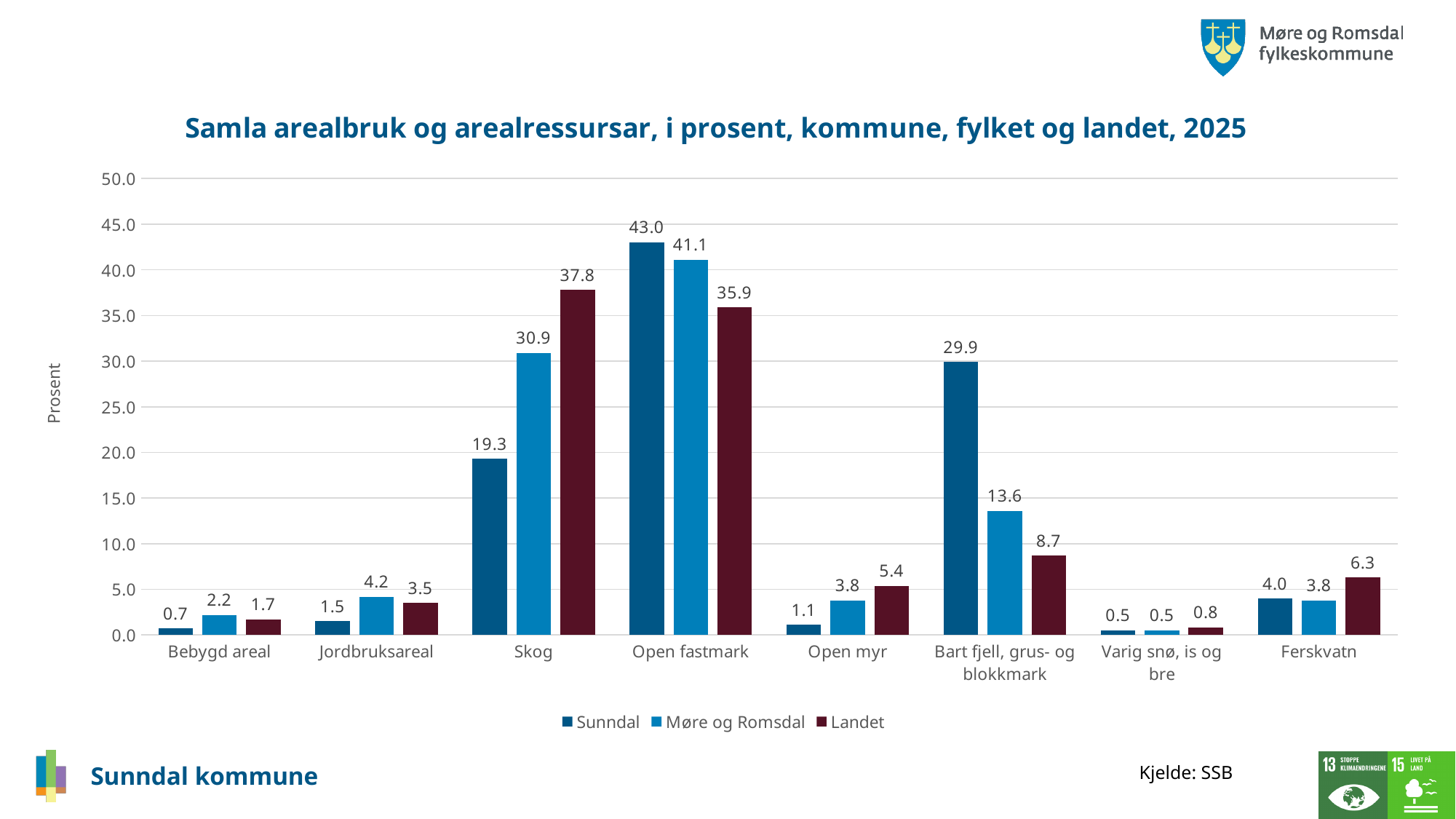
How many series does the legend list? 3 What is the value for Landet in the Open fastmark category? 35.9 What is the value for Møre og Romsdal in the Bart fjell, grus- og blokkmark category? 13.6 Which is larger in the Skog category: the value for Møre og Romsdal or the value for Landet? Landet What is the difference between the Sunndal and Landet values for Bart fjell, grus- og blokkmark? 21.2 Is the value for Sunndal in the Open fastmark category greater or less than 40.0? greater Which category has the lowest value for Landet? Varig snø, is og bre How many categories are shown on the x axis? 8 What is the title of the chart? Samla arealbruk og arealressursar, i prosent, kommune, fylket og landet, 2025 Which category has the highest value for Sunndal? Open fastmark What is the value for Sunndal in the Skog category? 19.3 What kind of chart is shown on the slide? bar chart